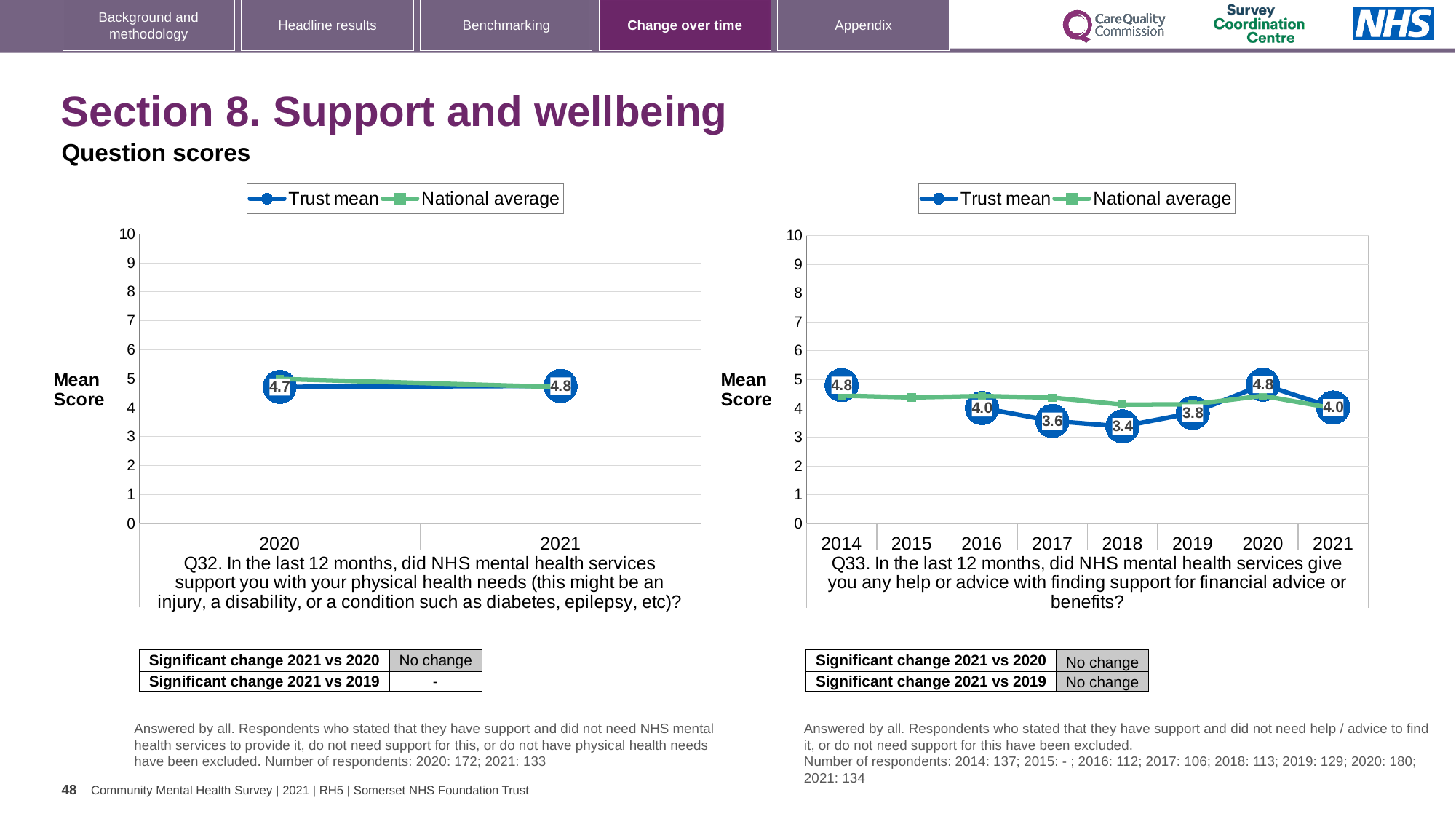
In the Q33 chart on the right, what is the Trust mean for 2021? 4.0 How many years are shown on the x axis of the Q33 chart on the right? 8 In the Q33 chart on the right, is the National average for 2014 greater or less than 4? greater In the Q32 chart on the left, what is the Trust mean for 2020? 4.7 In the Q32 chart on the left, does the Trust mean rise or fall from 2020 to 2021? rise What kind of chart is the Q33 chart on the right? line chart In the Q33 chart on the right, what is the difference between the Trust mean in 2020 and in 2021? 0.8 In the Q33 chart on the right, what is the Trust mean for 2018? 3.4 In the Q33 chart on the right, which year has the lowest Trust mean? 2018 How many series does the legend of the Q32 chart on the left list? 2 In the Q32 chart on the left, what is the Trust mean for 2021? 4.8 In the Q33 chart on the right, which is larger, the Trust mean for 2017 or for 2019? 2019